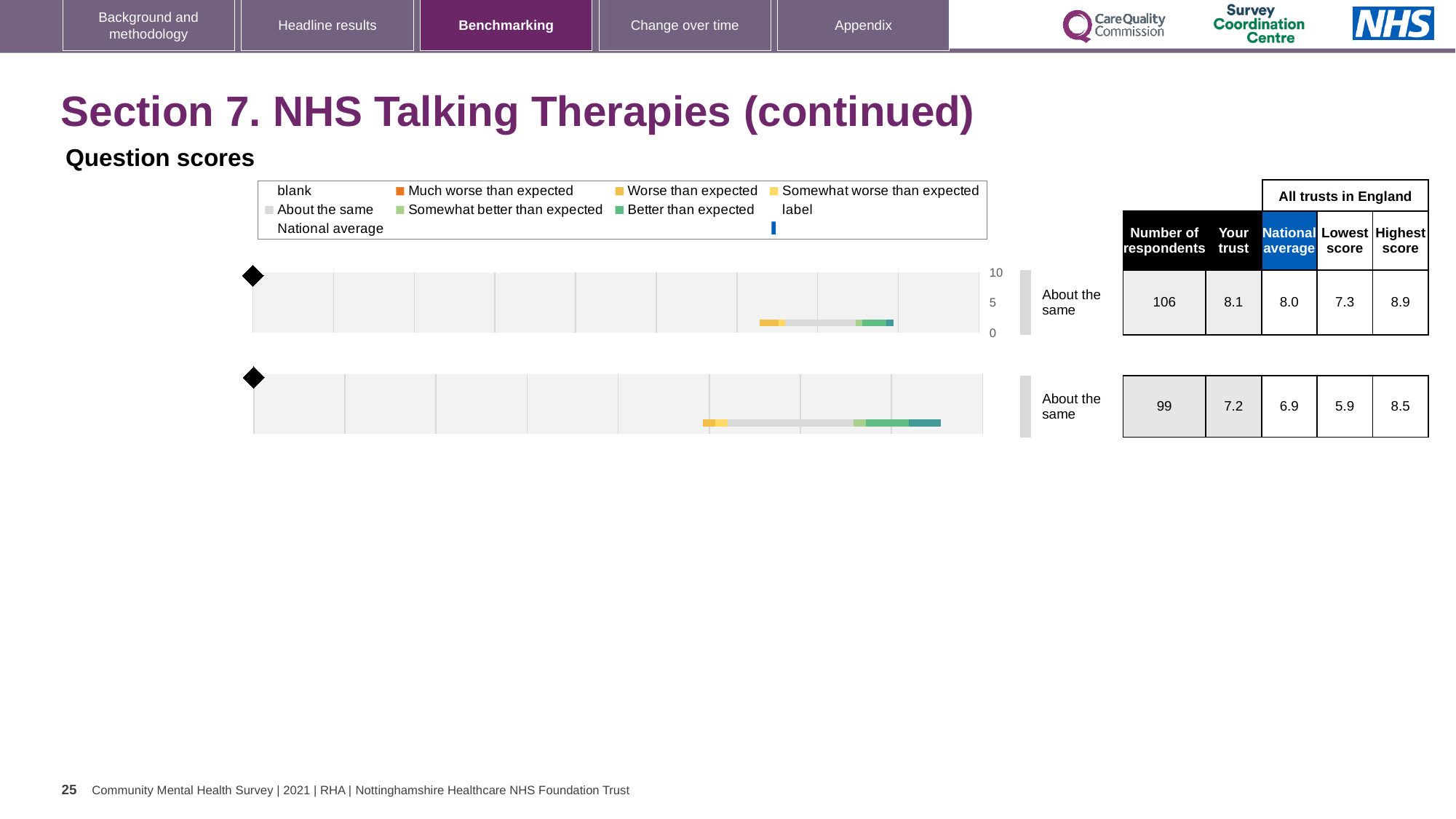
For the second (bottom) question row, how many respondents are there? 99 For the second (bottom) question row, how much higher is the 'Your trust' score than the national average? 0.3 For the first (top) question row, what is the difference between the highest score and the lowest score? 1.6 Which question row has more respondents, the first (top) or the second (bottom)? the first (top) What benchmark category label is shown next to both question rows? About the same For the second (bottom) question row, what is the highest score among all trusts in England? 8.5 What kind of chart is used to show the question scores on this slide? bar chart For the first (top) question row, what is the 'Your trust' score? 8.1 For the second (bottom) question row, what is the lowest score among all trusts in England? 5.9 How many question rows (bars) are plotted on the slide? 2 For the second (bottom) question row, which is larger: the 'Your trust' score or the national average? Your trust For the first (top) question row, what is the national average score? 8.0